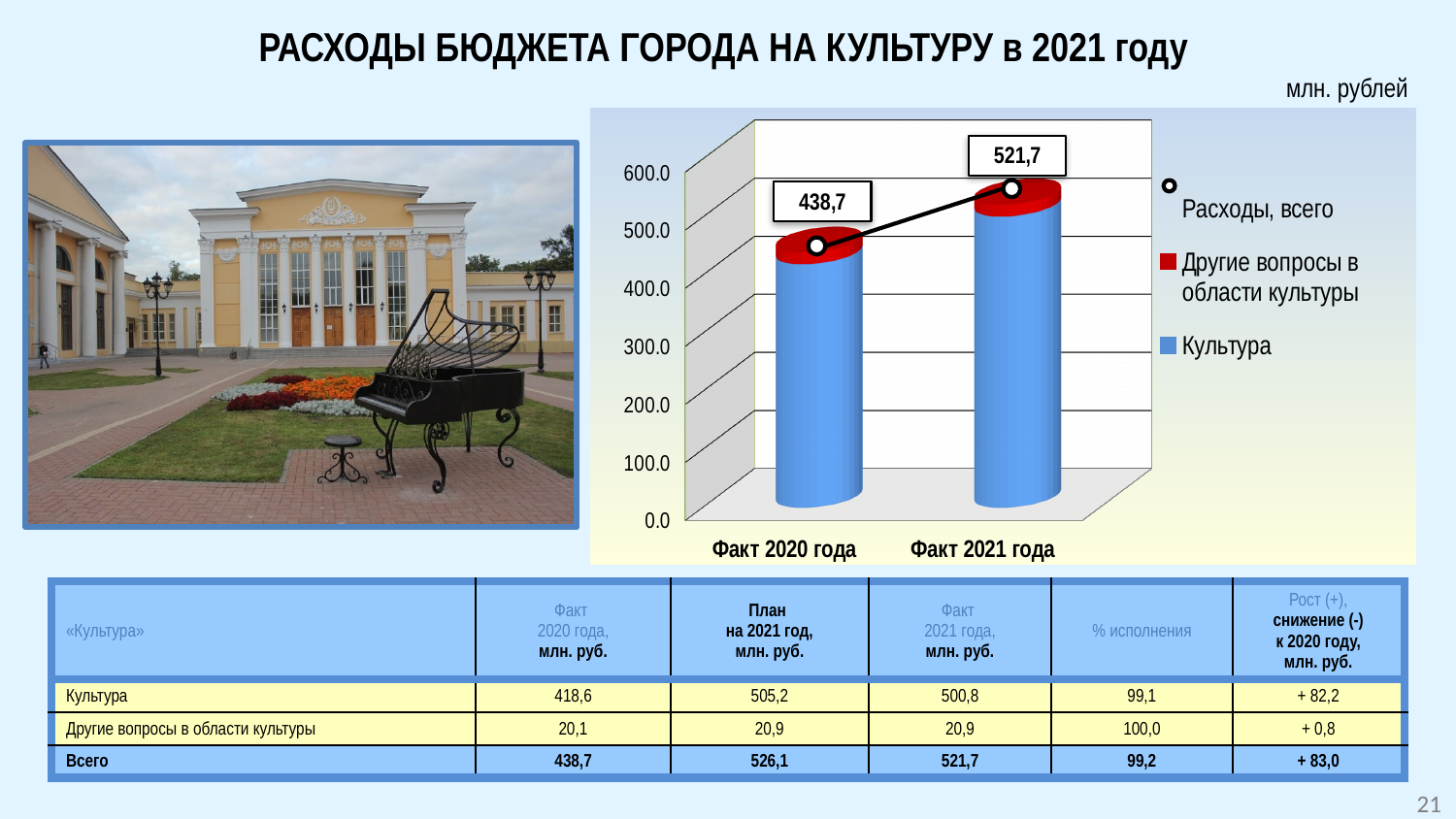
Is the Культура value for Факт 2021 года greater or less than 400.0? greater Which category has the higher total expenditure (Расходы, всего)? Факт 2021 года Which category has the lower total expenditure (Расходы, всего)? Факт 2020 года What is the value of Расходы, всего for Факт 2021 года? 521,7 Is the Культура value for Факт 2020 года greater or less than 400.0? greater What kind of chart is shown on the slide? bar chart What is the value of Расходы, всего for Факт 2020 года? 438,7 How many series does the chart legend list? 3 Does Расходы, всего rise or fall from Факт 2020 года to Факт 2021 года? rise Is Расходы, всего larger for Факт 2020 года or Факт 2021 года? Факт 2021 года What is the difference between Расходы, всего for Факт 2021 года and Факт 2020 года? 83,0 How many categories are shown on the x axis of the chart? 2